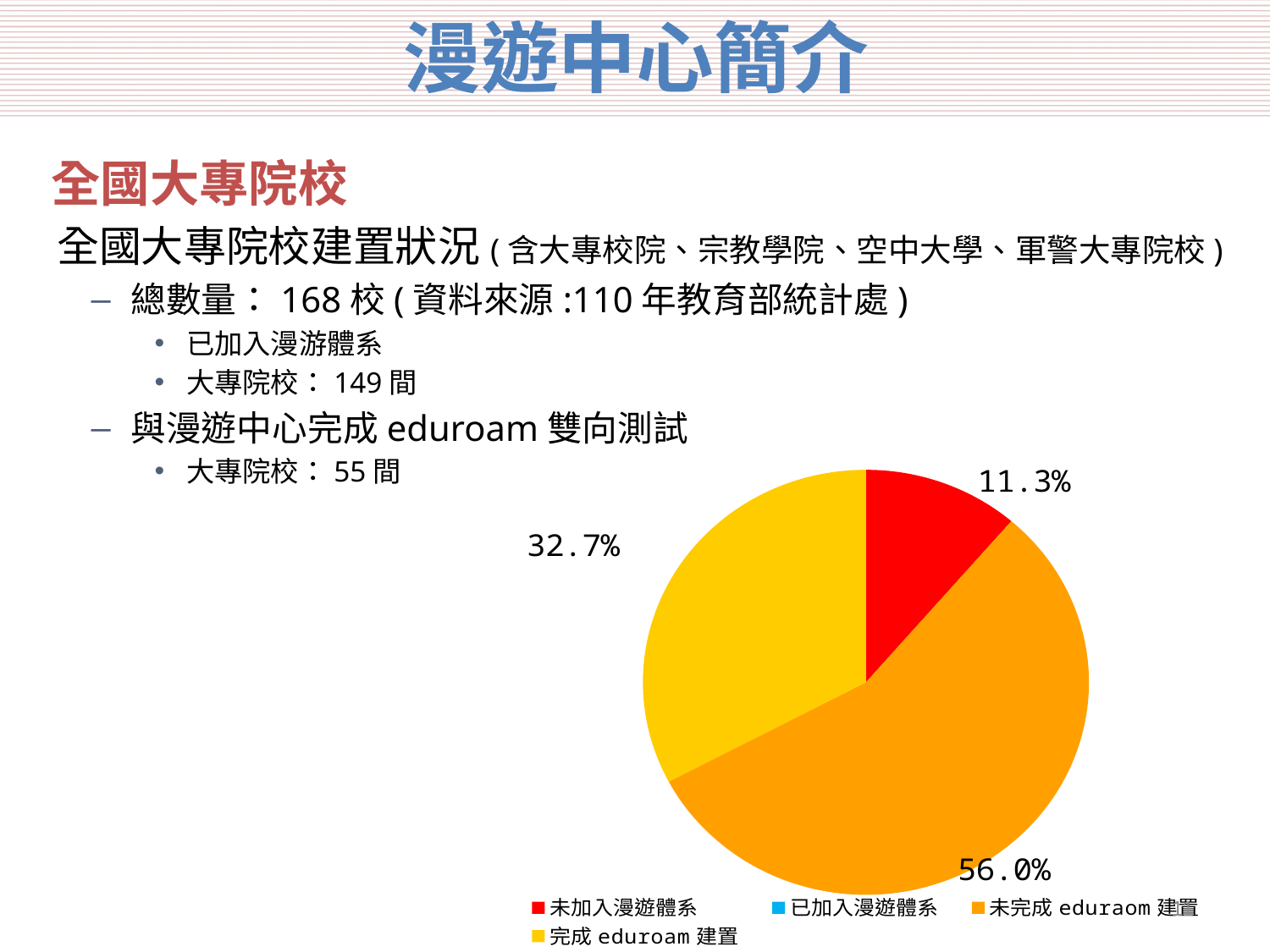
How many entries does the legend list? 4 What kind of chart is shown on the slide? pie chart What colour is the 未加入漫遊體系 slice? red What is the combined percentage of the 未加入漫遊體系 and 完成 eduroam 建置 slices? 44.0% What colour is the 未完成 eduraom 建置 slice? orange Which slice of the pie is the largest? 未完成 eduraom 建置 Which is larger, the 完成 eduroam 建置 slice or the 未加入漫遊體系 slice? 完成 eduroam 建置 What is the difference in percentage points between the 未完成 eduraom 建置 slice and the 完成 eduroam 建置 slice? 23.3 What percentage is shown for the 完成 eduroam 建置 slice? 32.7% Which labelled slice of the pie is the smallest? 未加入漫遊體系 What percentage is shown for the 未加入漫遊體系 slice? 11.3% What percentage is shown for the 未完成 eduraom 建置 slice? 56.0%